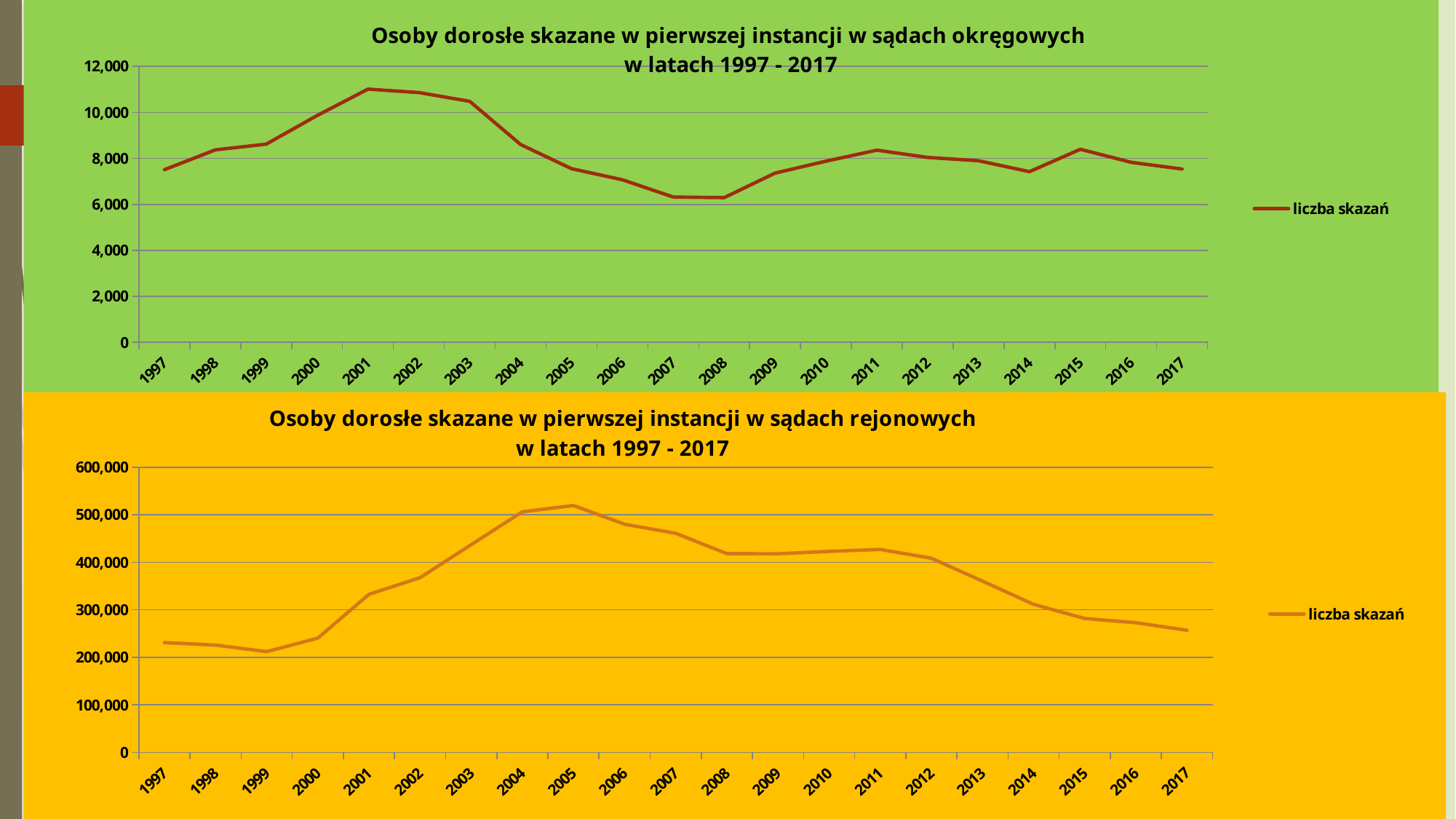
What kind of chart is the top chart, 'Osoby dorosłe skazane w pierwszej instancji w sądach okręgowych w latach 1997 - 2017'? line chart How many years are plotted on the x axis of the bottom chart about sądy rejonowe? 21 What is the legend entry shown in the bottom chart? liczba skazań In the top chart (sądy okręgowe), is the value for 2001 greater or less than 10,000? greater In the bottom chart (sądy rejonowe), do the values rise or fall from 2011 to 2017? fall In the bottom chart (sądy rejonowe), which year has the larger value, 2004 or 2014? 2004 In the bottom chart (sądy rejonowe), is the value for 2005 greater or less than 500,000? greater How many series does the legend of the top chart list? 1 In the bottom chart (sądy rejonowe), which year has the highest number of convictions? 2005 In the bottom chart (sądy rejonowe), is the value for 2017 greater or less than 300,000? less In the top chart (sądy okręgowe), which year has the highest number of convictions? 2001